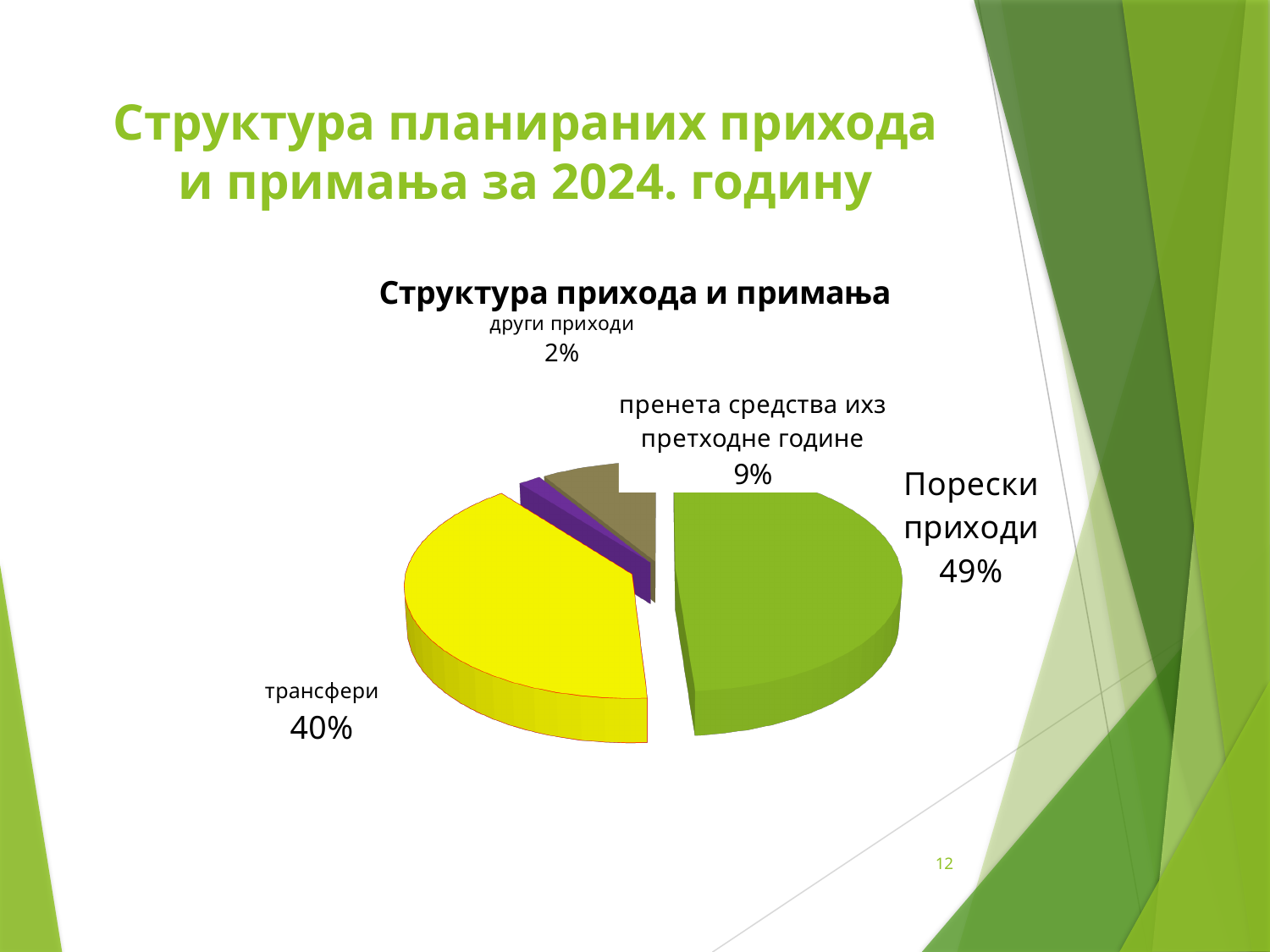
What is the value shown for пренета средства ихз претходне године? 9% What is the value shown for други приходи? 2% What colour is the slice for трансфери? Yellow Which category has the largest slice of the pie? Порески приходи What kind of chart is shown on the slide? Pie chart What is the difference in percentage points between Порески приходи and трансфери? 9 What share of the pie does Порески приходи represent? 49% Which is larger, трансфери or пренета средства ихз претходне године? трансфери What is the title of the chart? Структура прихода и примања What share of the pie does трансфери represent? 40% Which category has the smallest slice of the pie? други приходи How many categories are shown in the pie chart? 4